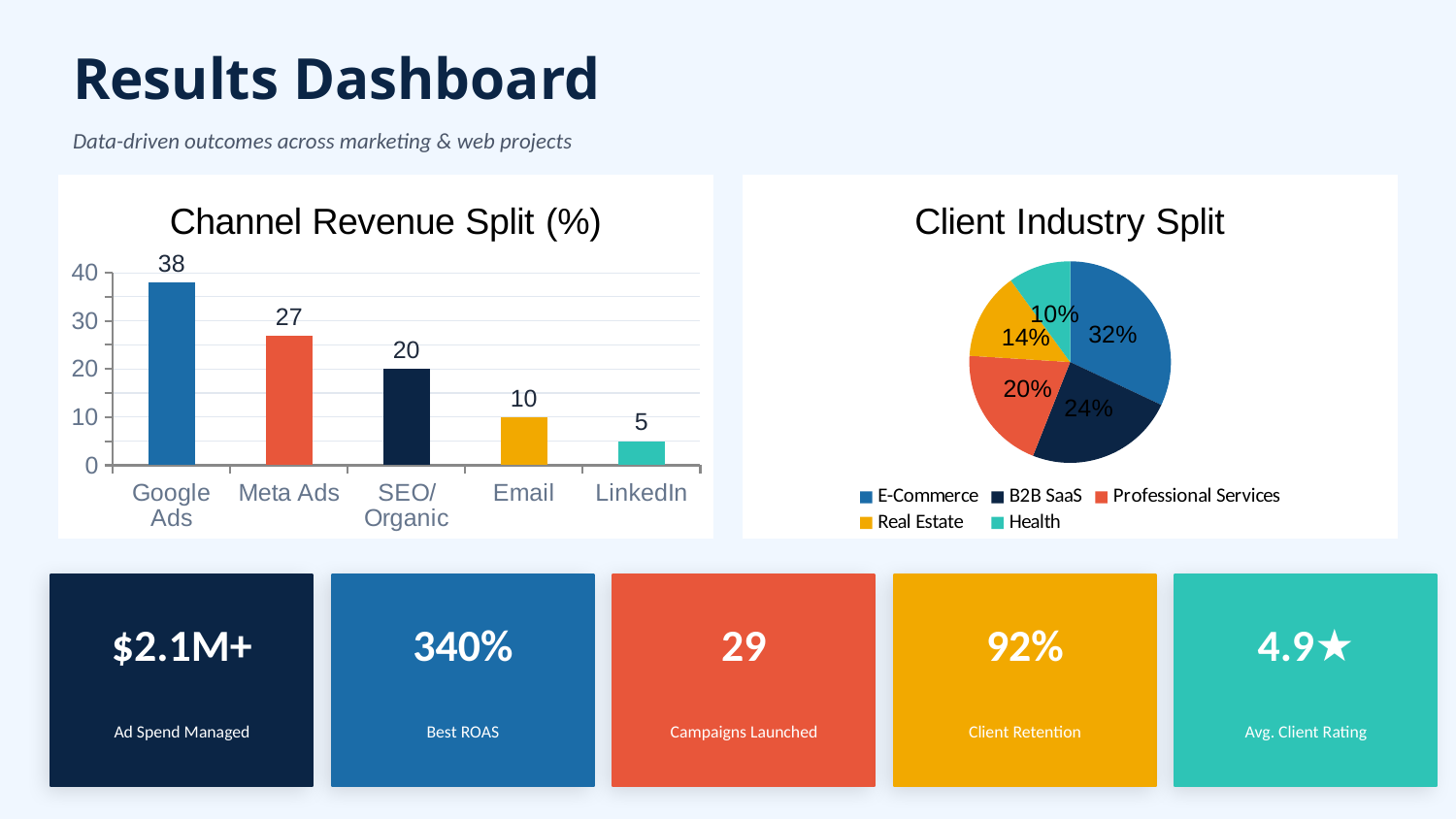
In the Channel Revenue Split (%) chart, which channel has the lowest value? LinkedIn In the Channel Revenue Split (%) chart, what is the value for SEO/Organic? 20 In the Channel Revenue Split (%) chart, what is the value for Google Ads? 38 In the Client Industry Split chart, which industry has the largest slice? E-Commerce In the Client Industry Split chart, what share does B2B SaaS have? 24% In the Channel Revenue Split (%) chart, do the values rise or fall from left to right? Fall In the Client Industry Split chart, which is larger: Professional Services or Real Estate? Professional Services In the Channel Revenue Split (%) chart, which channel has the highest value? Google Ads How many entries does the legend of the Client Industry Split chart list? 5 In the Channel Revenue Split (%) chart, how many channels are shown? 5 What kind of chart is the Channel Revenue Split (%) chart? Bar chart In the Channel Revenue Split (%) chart, what is the difference between Meta Ads and Email? 17